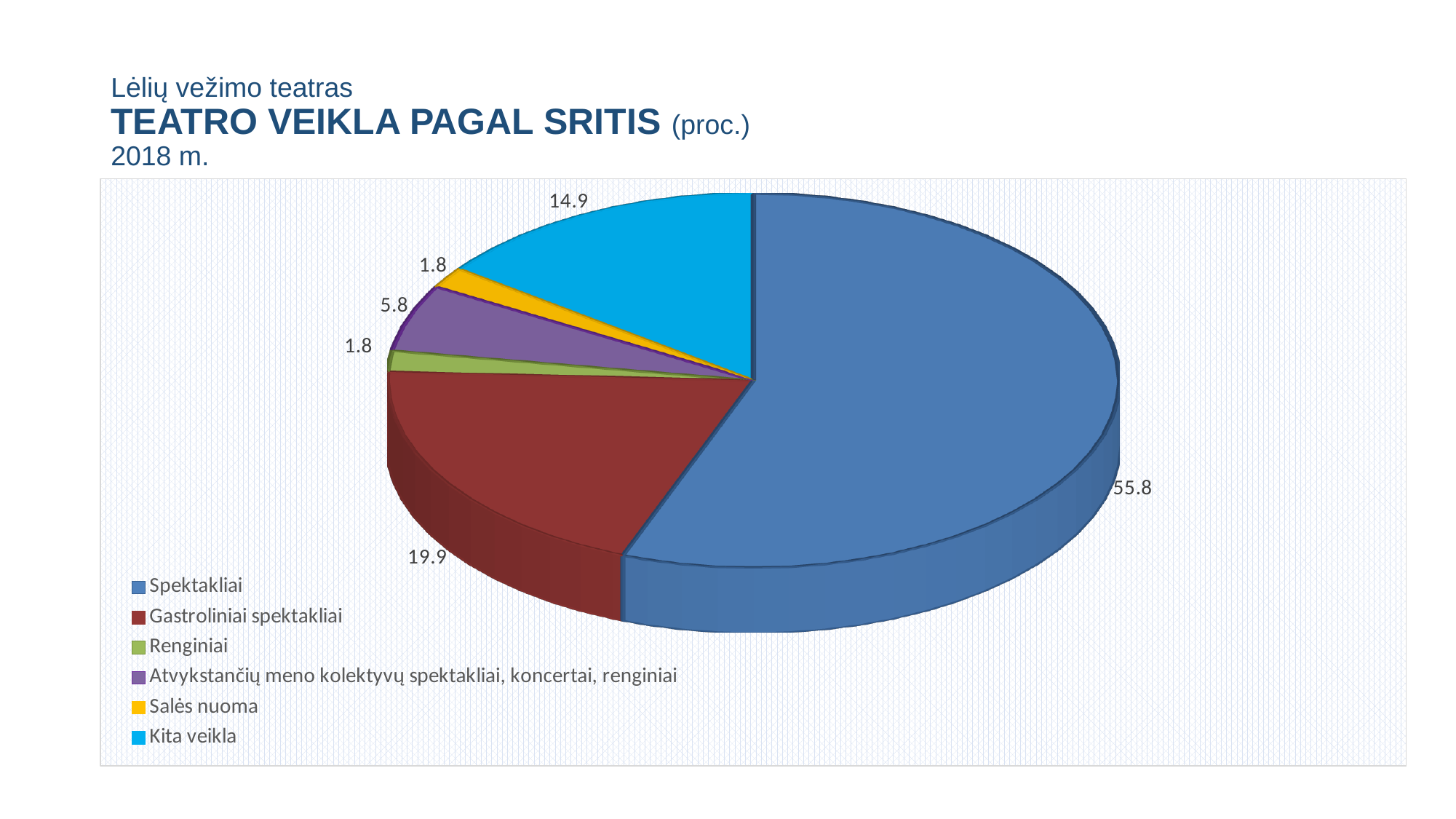
Which is larger, Kita veikla or Gastroliniai spektakliai? Gastroliniai spektakliai What is the value for Kita veikla? 14.9 What is the value for Spektakliai? 55.8 What kind of chart is shown on the slide? pie chart How many categories does the pie chart have? 6 Which year does the chart title refer to? 2018 m. Which category has the largest share of the pie? Spektakliai What is the difference between the values for Spektakliai and Gastroliniai spektakliai? 35.9 What is the value for Salės nuoma? 1.8 What is the value for Atvykstančių meno kolektyvų spektakliai, koncertai, renginiai? 5.8 What is the difference between the values for Kita veikla and Atvykstančių meno kolektyvų spektakliai, koncertai, renginiai? 9.1 What is the value for Gastroliniai spektakliai? 19.9